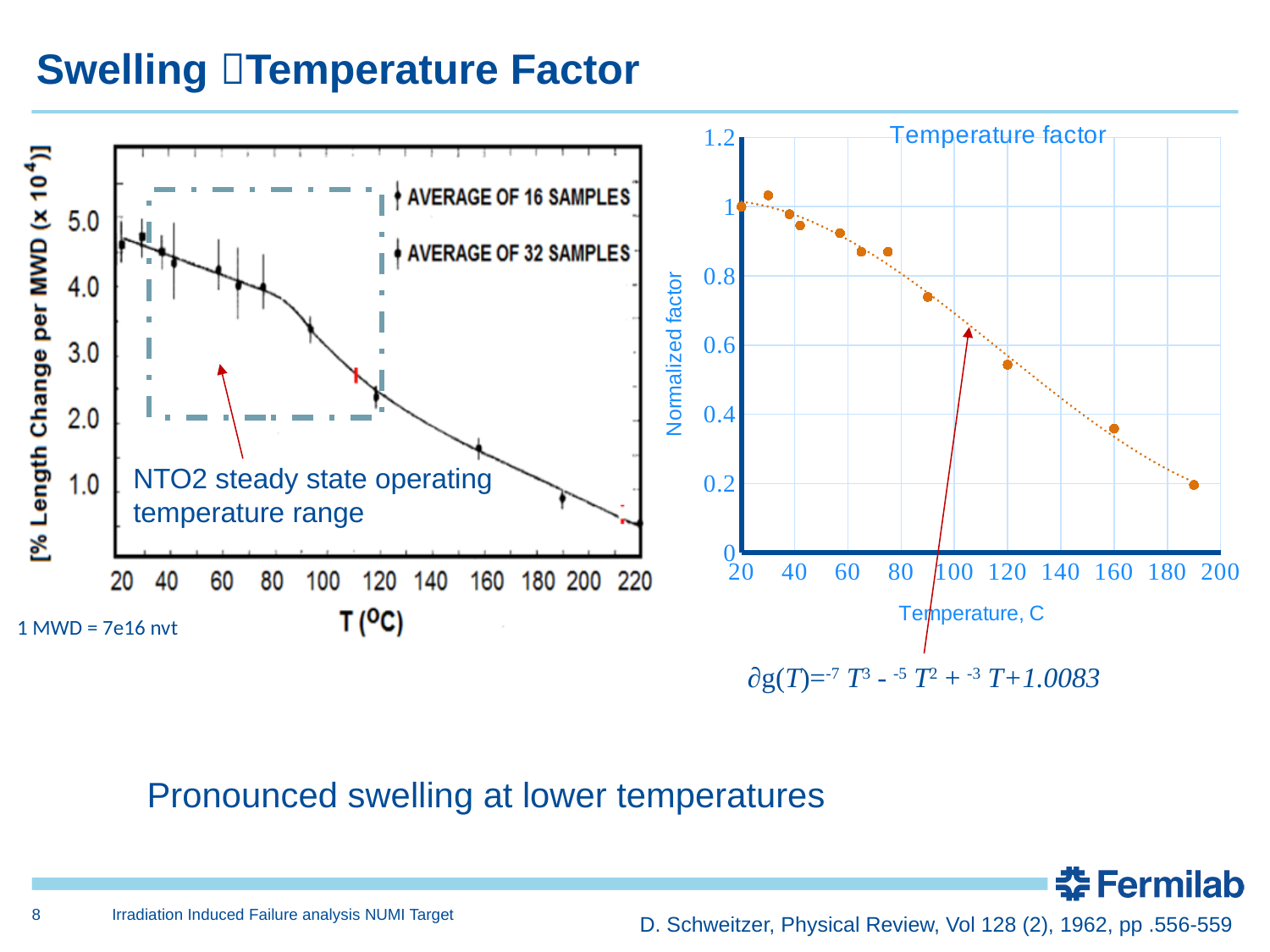
In the 'Temperature factor' chart, is the normalized factor at 90 C greater or less than 0.6? greater In the 'Temperature factor' chart, which has the larger normalized factor: the point at 60 C or the point at 160 C? 60 C In the left-hand chart, does the % length change per MWD rise or fall as temperature increases? fall How many series does the legend of the left-hand chart list? 2 In the 'Temperature factor' chart, is the normalized factor at 190 C greater or less than 0.4? less In the 'Temperature factor' chart, is the normalized factor at 120 C greater or less than 0.6? less What is the y-axis label of the 'Temperature factor' chart? Normalized factor In the 'Temperature factor' chart, at which temperature is the normalized factor lowest? 190 C How many data points are plotted in the 'Temperature factor' chart? 11 In the 'Temperature factor' chart, do the normalized factor values rise or fall as temperature increases? fall What kind of chart is the right-hand chart titled 'Temperature factor'? scatter chart